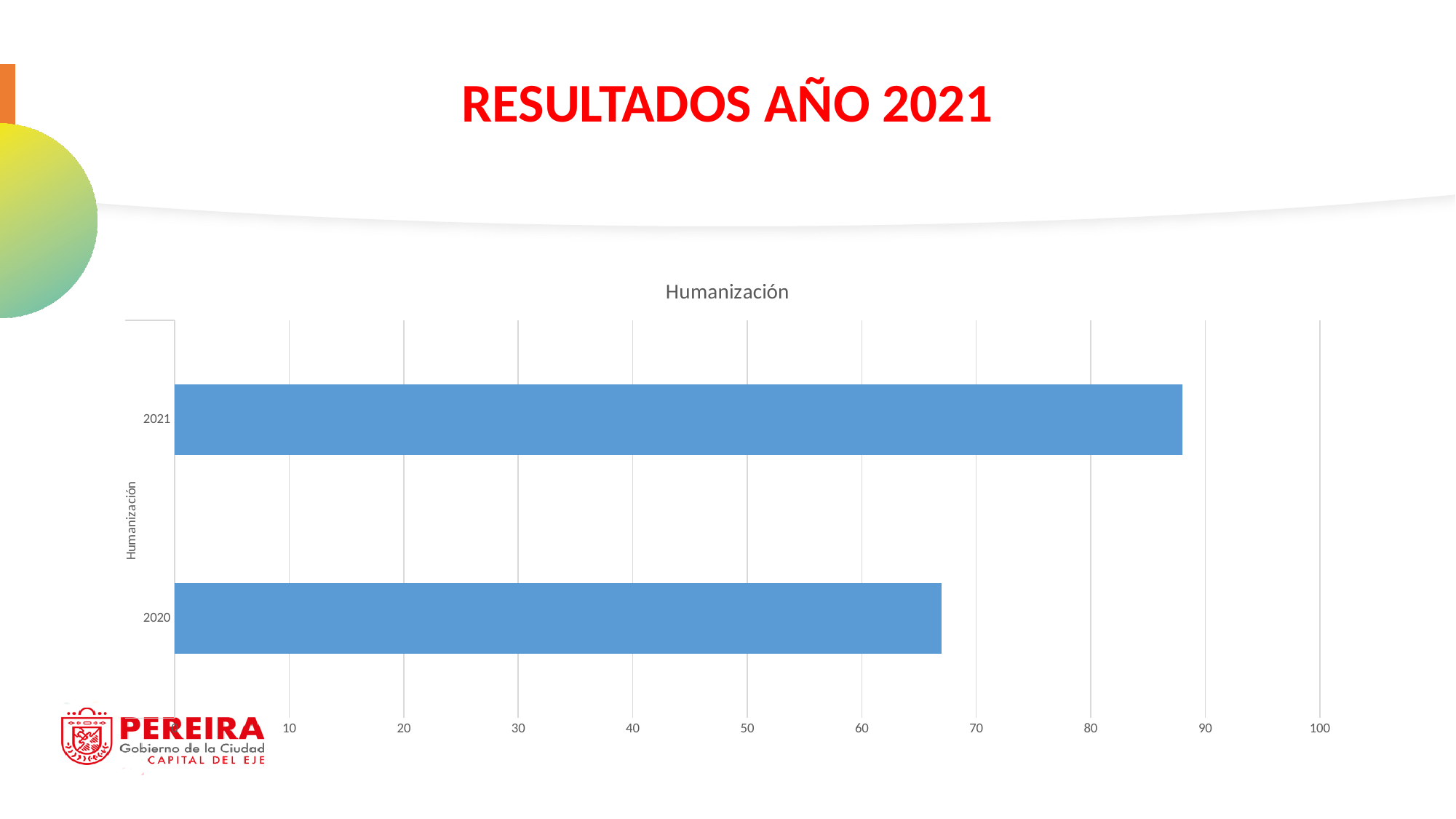
What is the title of the chart? Humanización Which year has the lowest value in the chart? 2020 Which is larger, the value for 2021 or the value for 2020? 2021 Is the value for 2020 greater or less than 70? less What kind of chart is shown on the slide? bar chart What label is shown on the vertical axis of the chart? Humanización Is the value for 2021 greater or less than 80? greater How many categories (bars) does the chart show? 2 Does the value rise or fall from 2020 to 2021? rise Which year has the highest value in the chart? 2021 Is the value for 2021 greater or less than 90? less